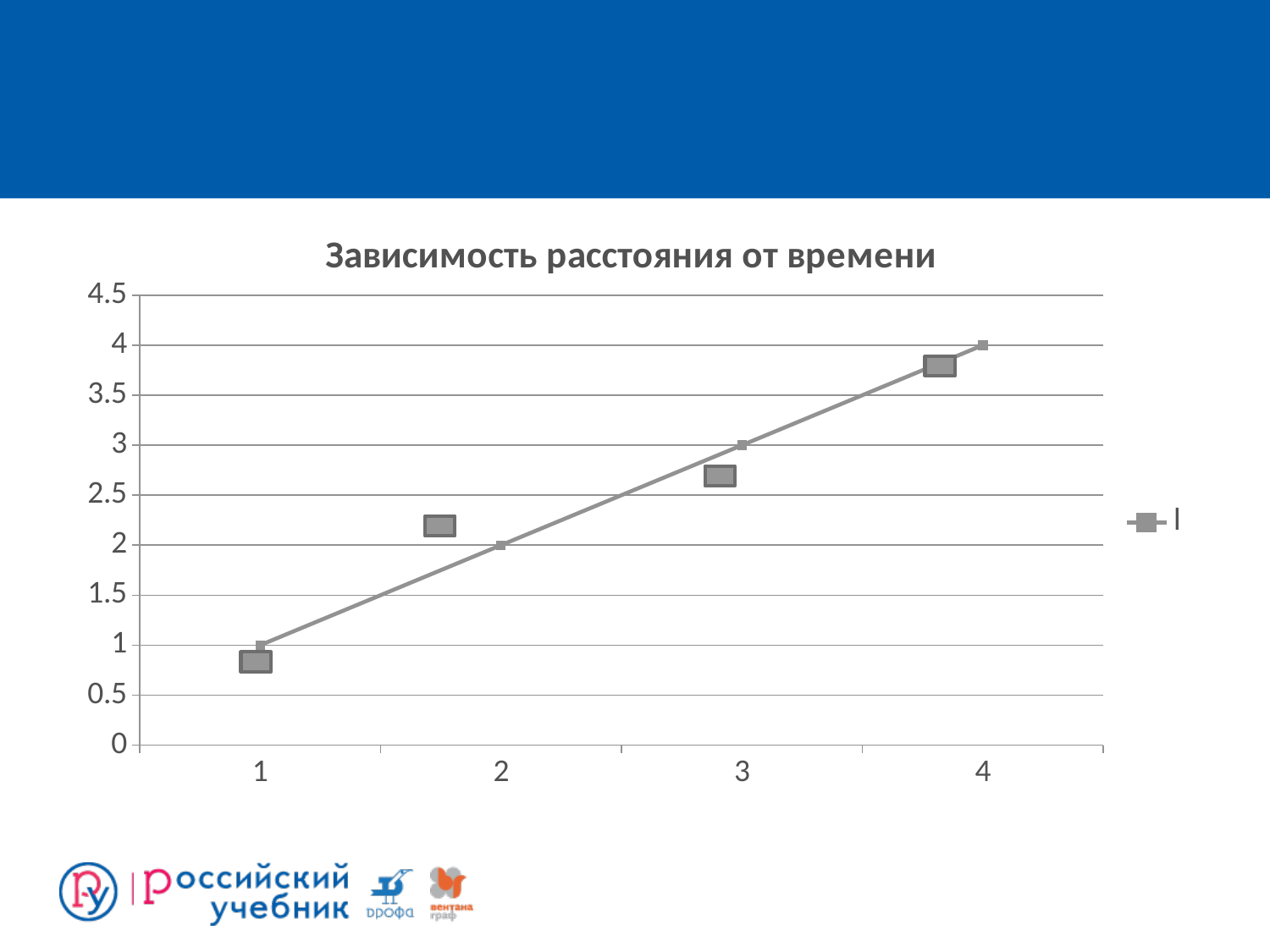
What is the value of the line at x = 3? 3 At which x value is the line lowest? 1 What is the difference between the value at x = 4 and the value at x = 2? 2 How many data points are plotted on the line? 4 At which x value is the line highest? 4 What is the value of the line at x = 1? 1 Do the values rise or fall as x increases from 1 to 4? rise How many series does the legend list? 1 What is the title of the chart? Зависимость расстояния от времени What kind of chart is shown on the slide? line chart What is the value of the line at x = 4? 4 What is the name of the series shown in the legend? l